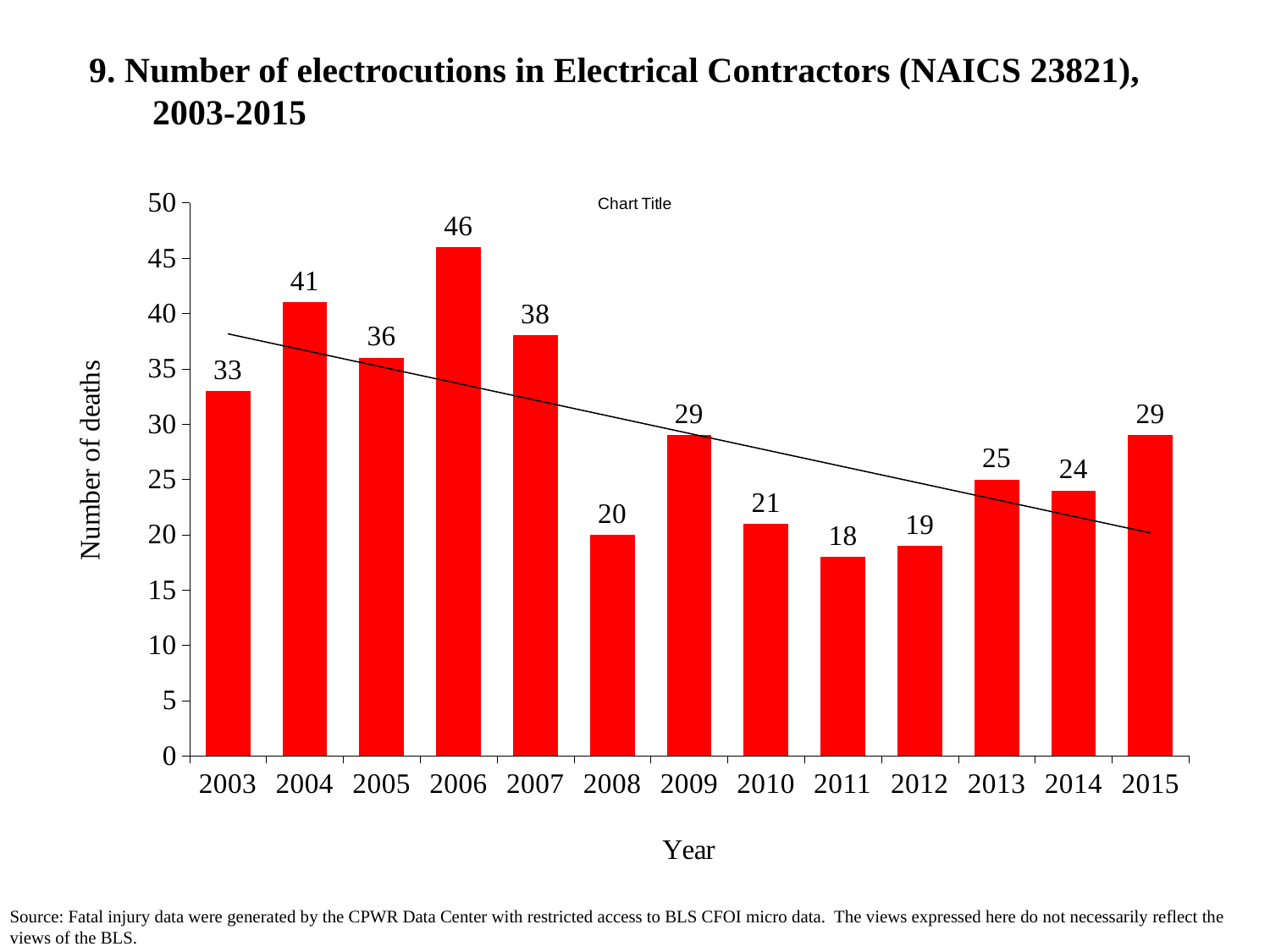
How many years are shown on the x axis? 13 Which year has the lowest number of electrocutions? 2011 What is the difference between the number of electrocutions in 2004 and in 2008? 21 Does the trend line show the number of electrocutions rising or falling from 2003 to 2015? falling What is the label of the y axis? Number of deaths What kind of chart is shown on the slide? bar chart Which year has more electrocutions, 2007 or 2014? 2007 Which year has the highest number of electrocutions? 2006 Is the value for 2005 greater or less than 30? greater What is the number of electrocutions in 2013? 25 What is the number of electrocutions in 2006? 46 What is the number of electrocutions in 2011? 18